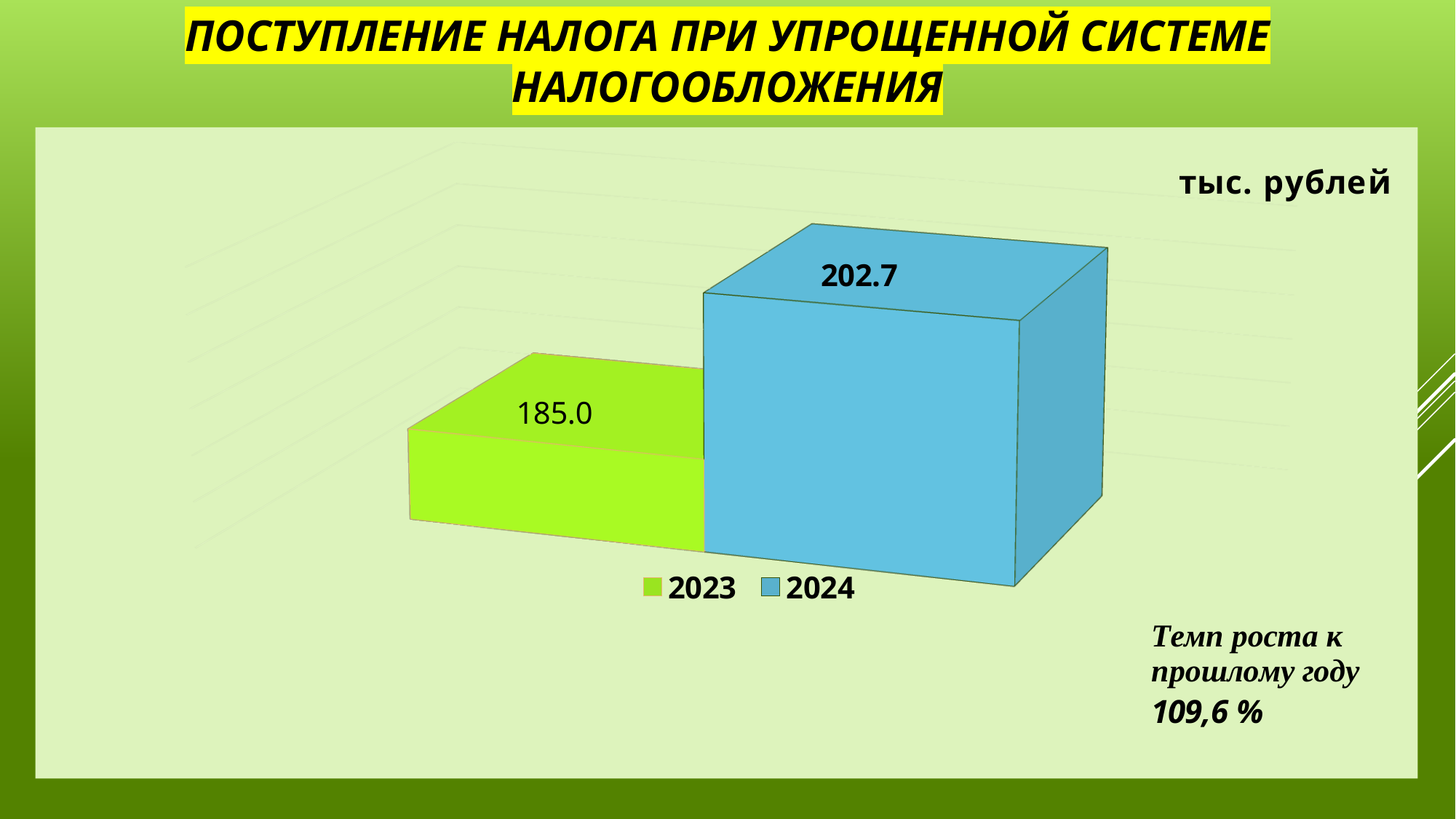
Do the values rise or fall from 2023 to 2024? Rise What growth rate to the previous year is stated on the slide? 109,6 % What unit is stated for the chart values? тыс. рублей What is the value for 2023? 185.0 What kind of chart is shown on the slide? Bar chart How many series does the legend list? 2 Which year has the higher value? 2024 Which year has the lower value? 2023 What is the difference between the 2024 and 2023 values? 17.7 Is the value for 2024 larger than the value for 2023? Yes What is the value for 2024? 202.7 How many bars are plotted on the chart? 2